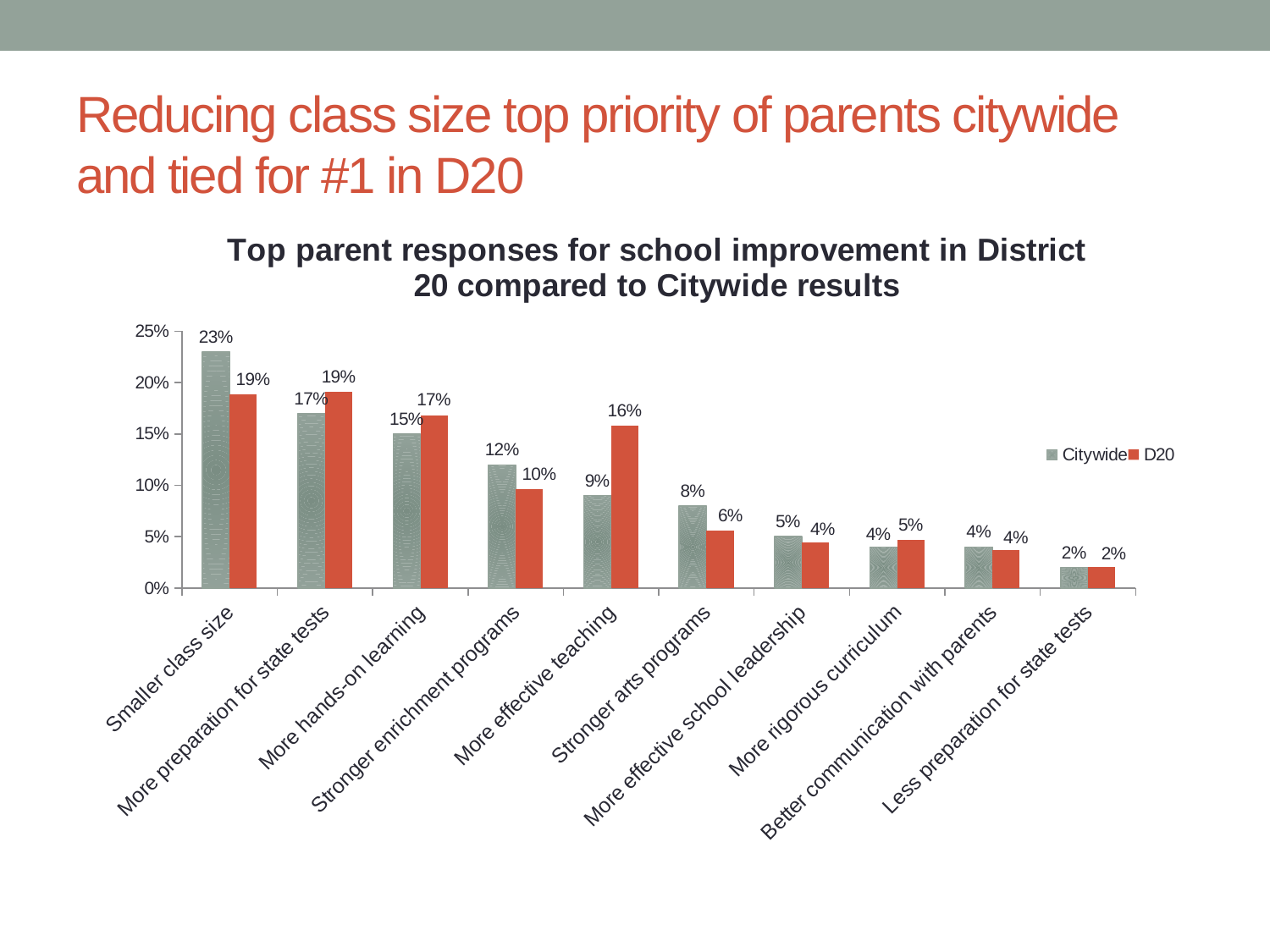
Which category has the lowest D20 value? Less preparation for state tests Which category has the highest Citywide value? Smaller class size What kind of chart is shown on the slide? Bar chart How many series does the legend list? 2 What is the D20 value for Stronger enrichment programs? 10% What is the difference between the Citywide and D20 values for More effective teaching? 7% Which is larger for More preparation for state tests, the Citywide value or the D20 value? D20 What is the title of the chart? Top parent responses for school improvement in District 20 compared to Citywide results How many categories are shown on the x axis? 10 What is the Citywide value for Smaller class size? 23% Is the Citywide value for Smaller class size greater or less than 20%? greater What is the D20 value for More effective teaching? 16%